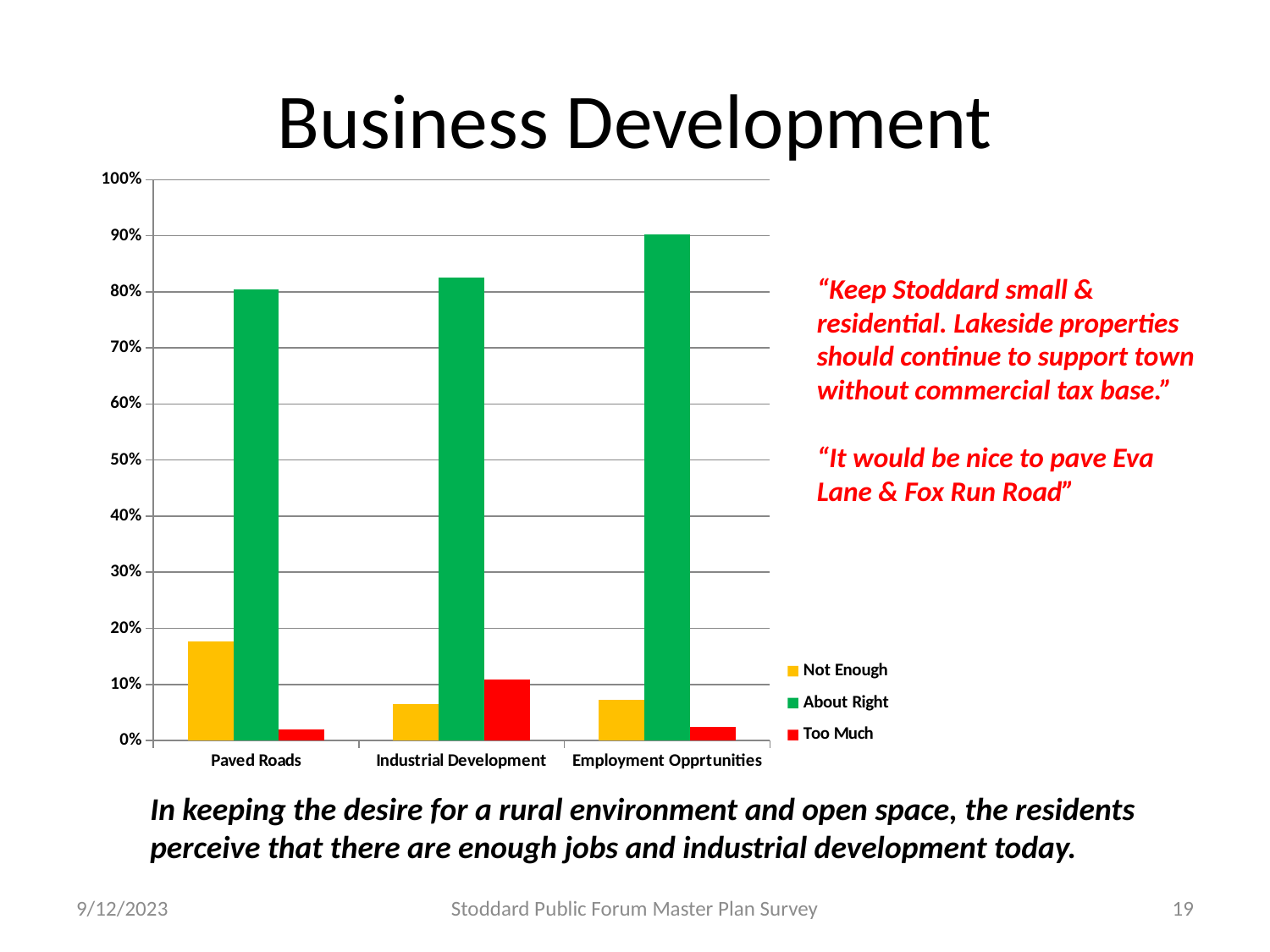
Is the Too Much value for Industrial Development greater or less than 20%? less For Paved Roads, which is larger: the Not Enough value or the Too Much value? Not Enough Which category has the highest Too Much value? Industrial Development Is the Not Enough value for Paved Roads greater or less than 10%? greater Which colour represents the About Right series in the chart? green Which category has the highest About Right value? Employment Opprtunities How many series does the chart legend list? 3 Is the Not Enough value for Employment Opprtunities greater or less than 10%? less How many categories are shown on the x axis of the chart? 3 What kind of chart is shown on the slide? bar chart Which category has the highest Not Enough value? Paved Roads